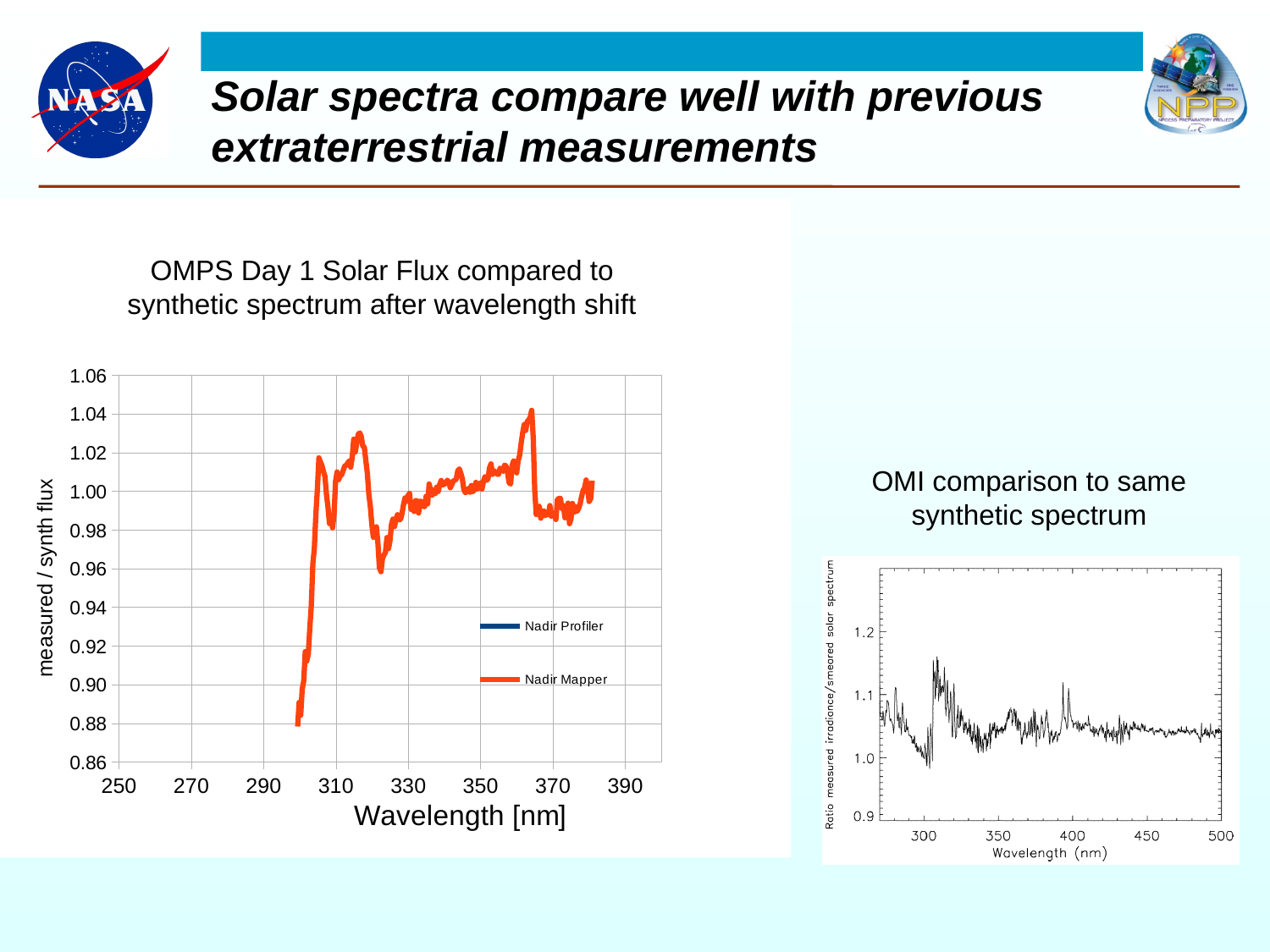
In the right chart (OMI comparison to same synthetic spectrum), what is the label of the x axis? Wavelength (nm) In the left chart (OMPS Day 1 Solar Flux), what are the two series named in the legend? Nadir Profiler and Nadir Mapper What kind of chart is the left chart titled 'OMPS Day 1 Solar Flux compared to synthetic spectrum after wavelength shift'? line chart In the right chart (OMI comparison to same synthetic spectrum), is the peak value near 310 nm greater or less than 1.1? greater In the left chart (OMPS Day 1 Solar Flux), does the Nadir Mapper line rise or fall between 300 nm and 305 nm? rise In the left chart (OMPS Day 1 Solar Flux), which is larger for Nadir Mapper: the value at 300 nm or the value at 380 nm? the value at 380 nm In the left chart (OMPS Day 1 Solar Flux), what is the label of the y axis? measured / synth flux In the left chart (OMPS Day 1 Solar Flux), is the peak Nadir Mapper value near 365 nm greater or less than 1.02? greater In the left chart (OMPS Day 1 Solar Flux), how many series does the legend list? 2 In the right chart (OMI comparison to same synthetic spectrum), is the value at 450 nm greater or less than 1.1? less